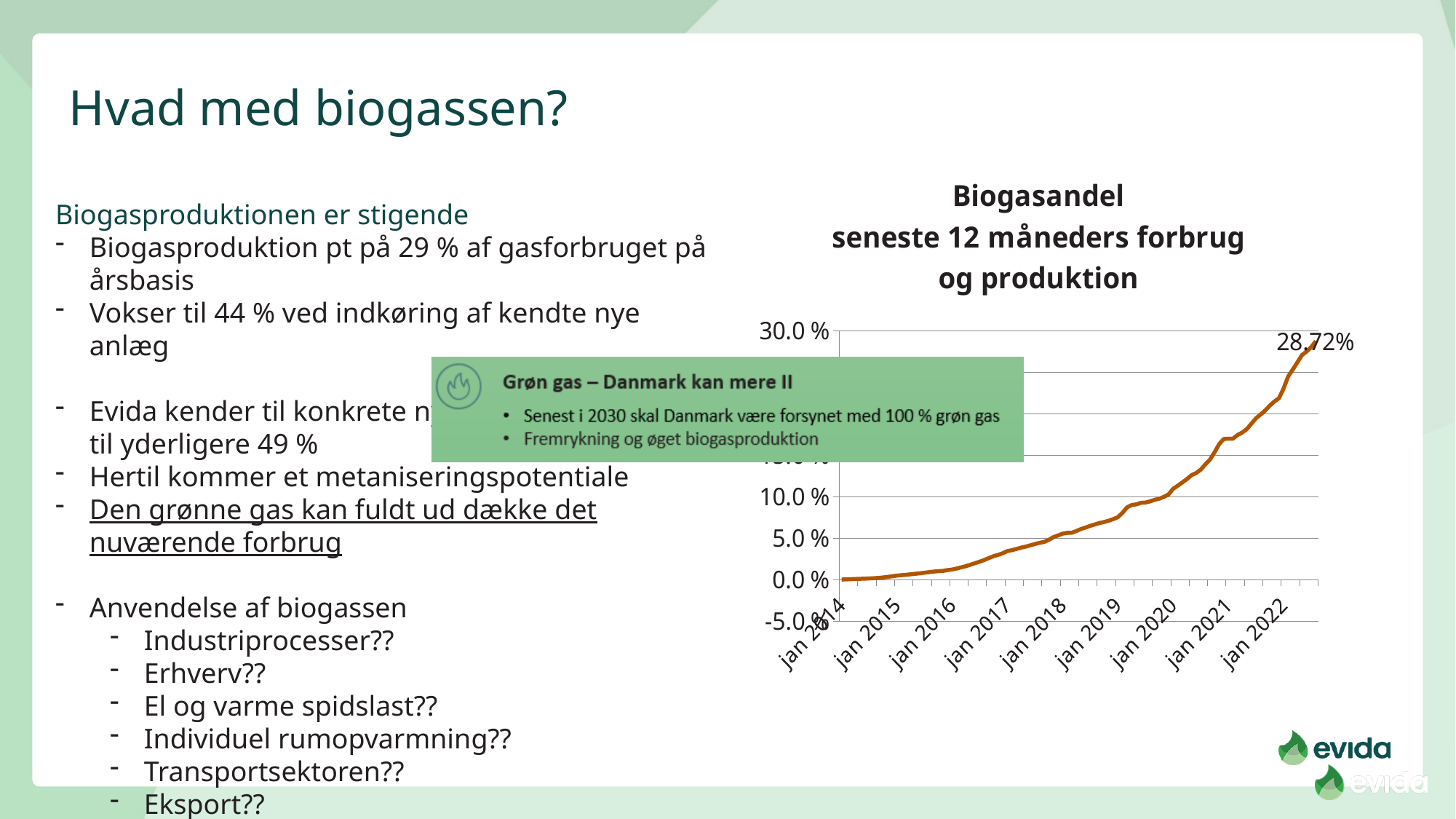
Does the biogas share rise or fall from jan 2014 to jan 2022? rise Is the value for jan 2017 greater or less than 5.0 %? less Is the value for jan 2021 greater or less than 10.0 %? greater Is the value for jan 2015 greater or less than 5.0 %? less What is the value shown by the data label at the end of the line? 28.72% What is the title of the chart? Biogasandel seneste 12 måneders forbrug og produktion How many year labels are shown on the x axis? 9 What is the highest tick value shown on the y axis? 30.0 % What is the highest value labelled on the chart? 28.72% What kind of chart is shown on the slide? line chart